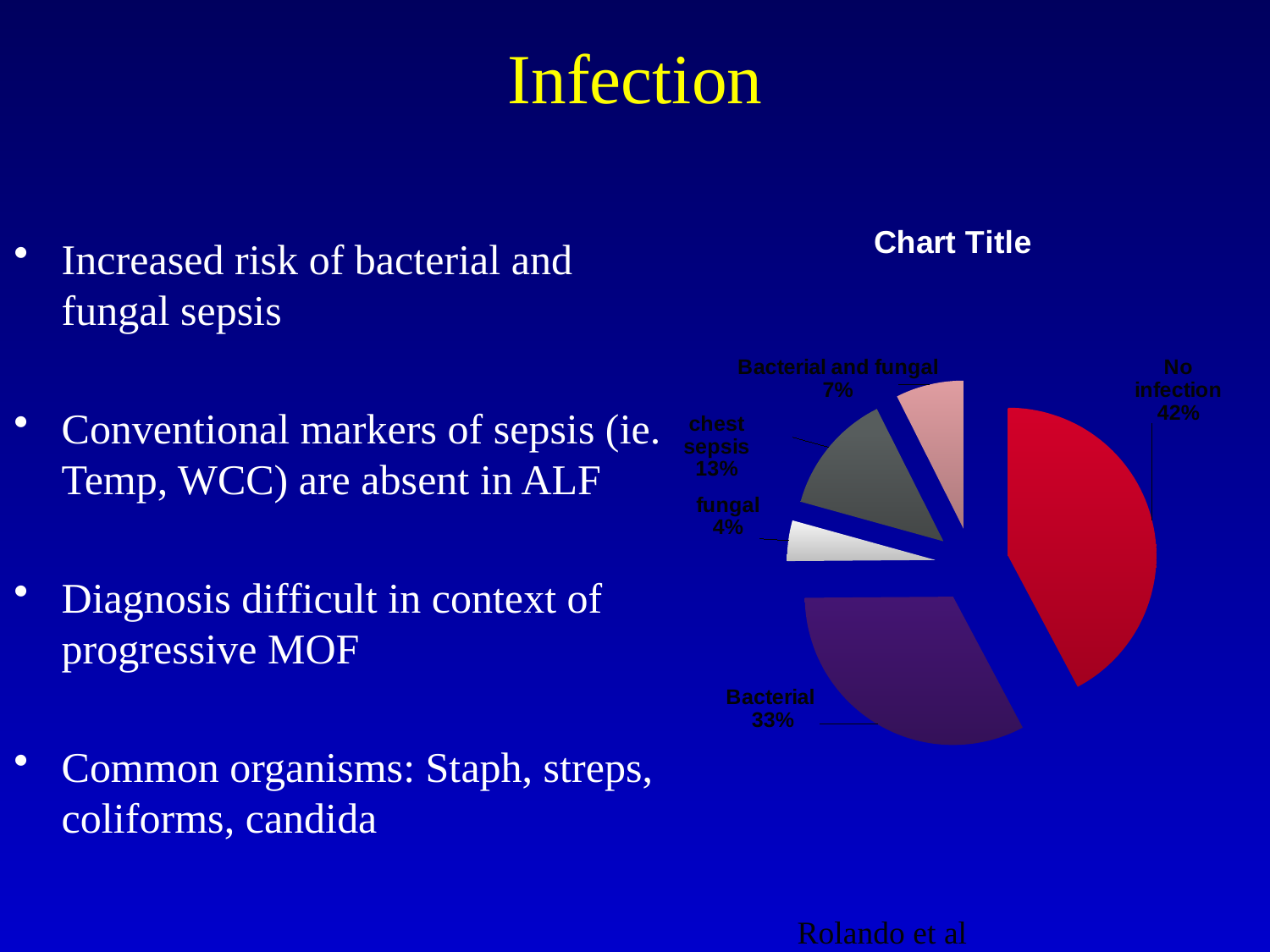
What percentage of the pie is labelled 'chest sepsis'? 13% What percentage of the pie is labelled 'Bacterial'? 33% Which slice of the pie is the largest? No infection Which slice of the pie is the smallest? fungal What kind of chart is shown on the slide? pie chart What percentage of the pie is labelled 'fungal'? 4% What is the difference in percentage points between the 'No infection' slice and the 'Bacterial' slice? 9 Which is larger, the 'chest sepsis' slice or the 'Bacterial and fungal' slice? chest sepsis What percentage of the pie is labelled 'Bacterial and fungal'? 7% What is the title shown above the pie chart? Chart Title What percentage of the pie is labelled 'No infection'? 42% How many slices does the pie chart have? 5